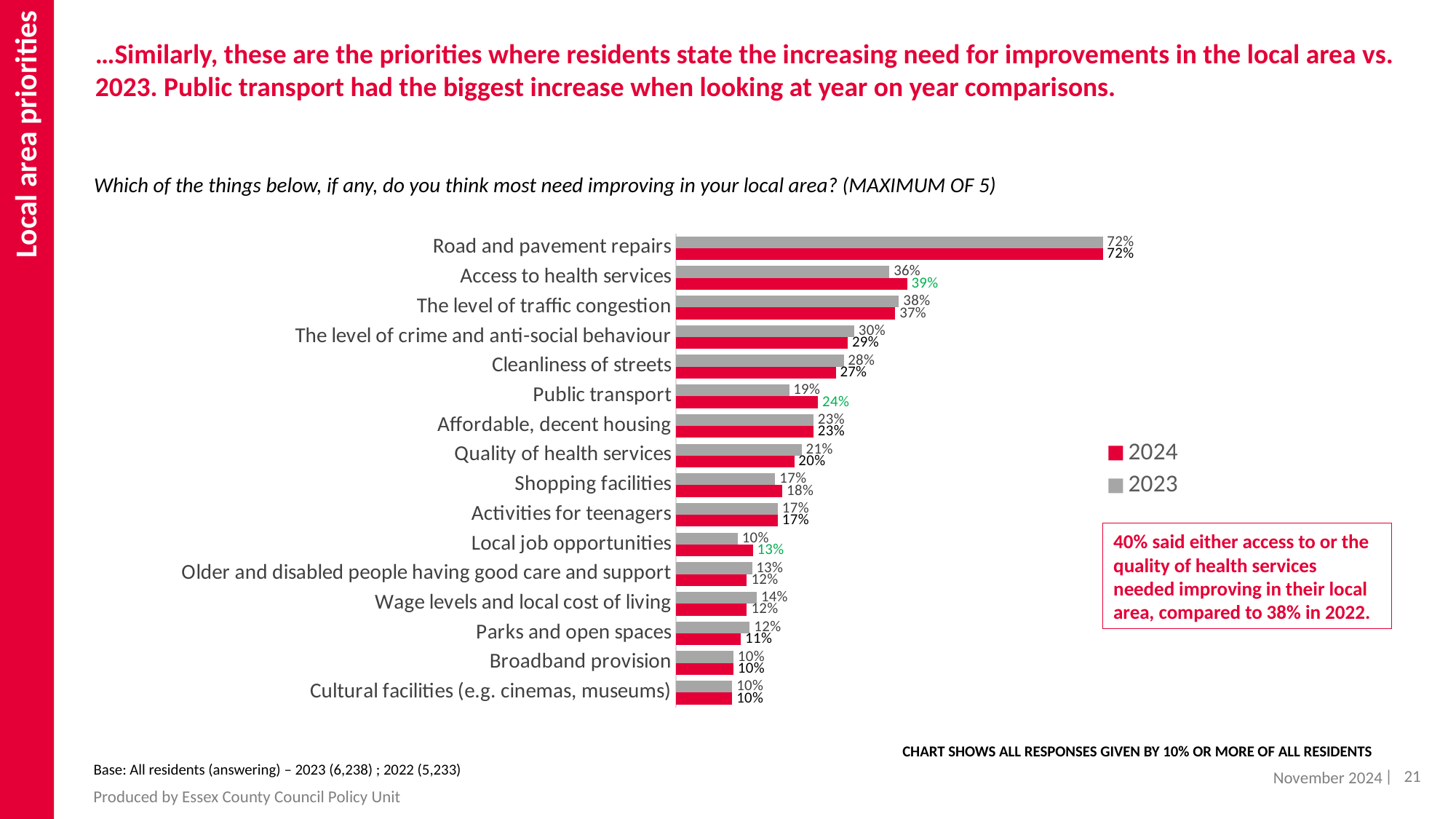
For Wage levels and local cost of living, which year has the larger value, 2023 or 2024? 2023 How many categories are shown in the chart? 16 What is the 2024 value for Local job opportunities? 13% What is the 2024 value for Public transport? 24% What kind of chart is shown on the slide? Bar chart For Shopping facilities, which year has the larger value, 2023 or 2024? 2024 Which colour represents the 2023 series in the chart? Grey What is the 2023 value for Access to health services? 36% Which category has the highest 2024 value? Road and pavement repairs What is the difference between the 2024 and 2023 values for Access to health services? 3% How many series does the legend list? 2 What is the difference between the 2024 and 2023 values for Public transport? 5%